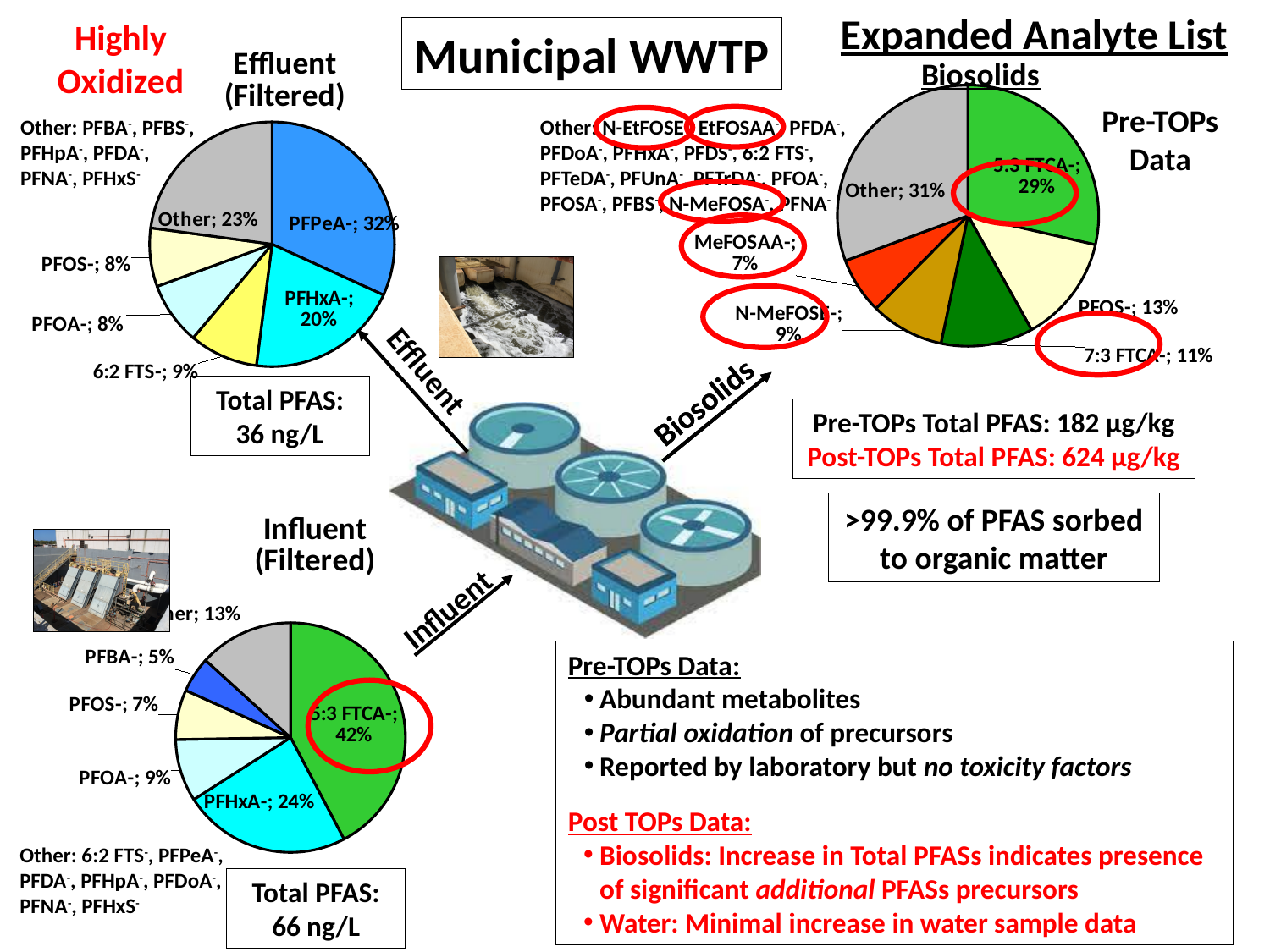
In the Influent (Filtered) pie chart, what share does 5:3 FTCA- have? 42% In the Effluent (Filtered) pie chart, which labelled slice is the largest? PFPeA- In the Biosolids pie chart, what share does 7:3 FTCA- have? 11% In the Biosolids pie chart, which is larger, the PFOS- slice or the MeFOSAA- slice? PFOS- In the Effluent (Filtered) pie chart, what share does PFHxA- have? 20% In the Influent (Filtered) pie chart, what share does PFHxA- have? 24% In the Biosolids pie chart, which labelled slice is the smallest? MeFOSAA- In the Effluent (Filtered) pie chart, what share does PFPeA- have? 32% In the Influent (Filtered) pie chart, how many slices are shown? 6 What type of chart is used for the Influent (Filtered) data? Pie chart In the Biosolids pie chart, what share does 5:3 FTCA- have? 29% In the Effluent (Filtered) pie chart, what is the difference between the PFPeA- share and the 6:2 FTS- share? 23%